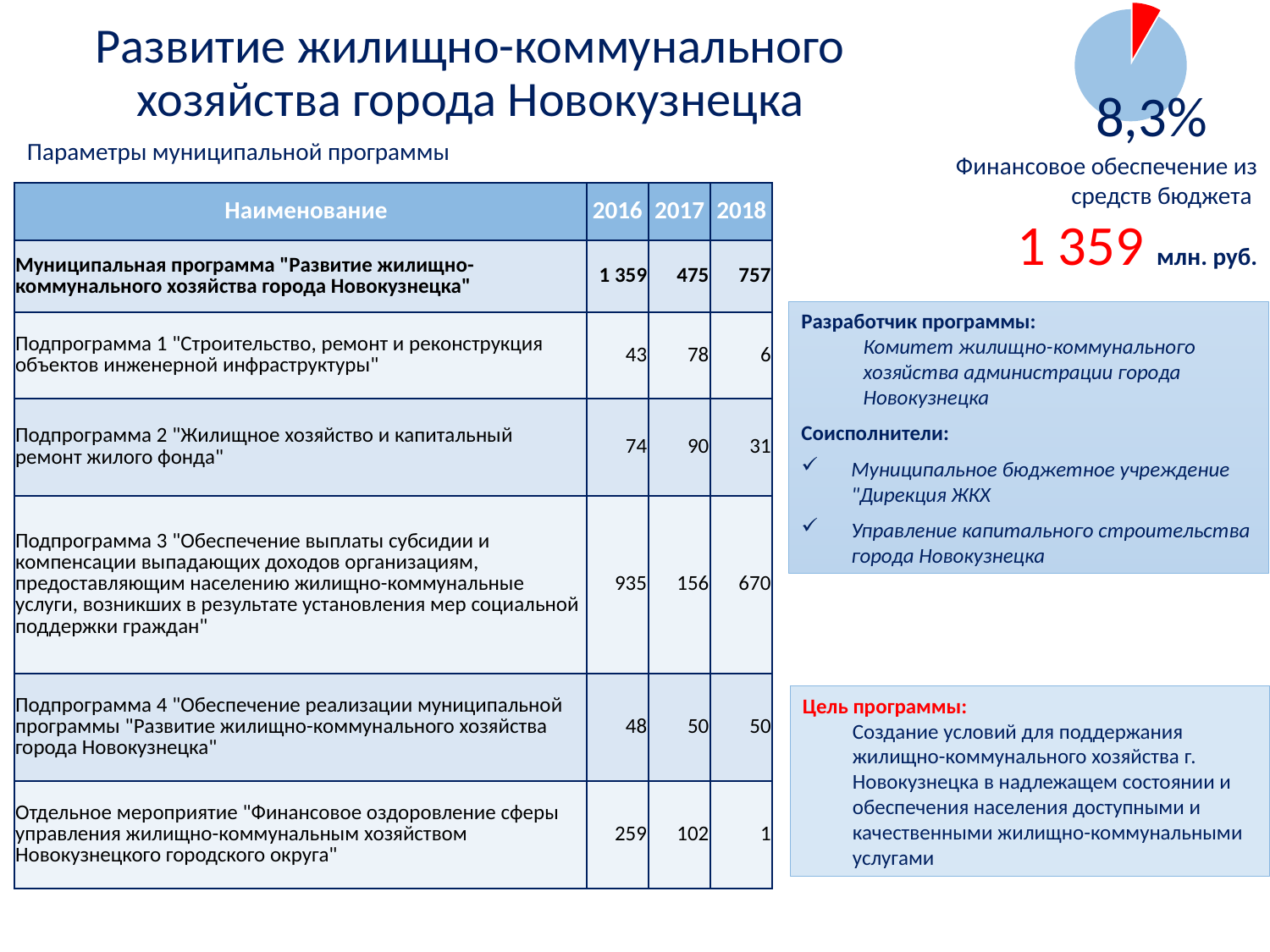
What amount in million rubles is shown next to the pie chart as the financial provision from the budget? 1 359 млн. руб. How many slices does the pie chart have? 2 What kind of chart is shown in the top right corner of the slide? pie chart What share does the highlighted (red) slice of the pie chart represent? 8,3% Which slice of the pie chart is larger, the red slice or the light blue slice? the light blue slice Is the share shown by the red slice of the pie chart greater or less than 10%? less What colour is the small highlighted slice of the pie chart? red